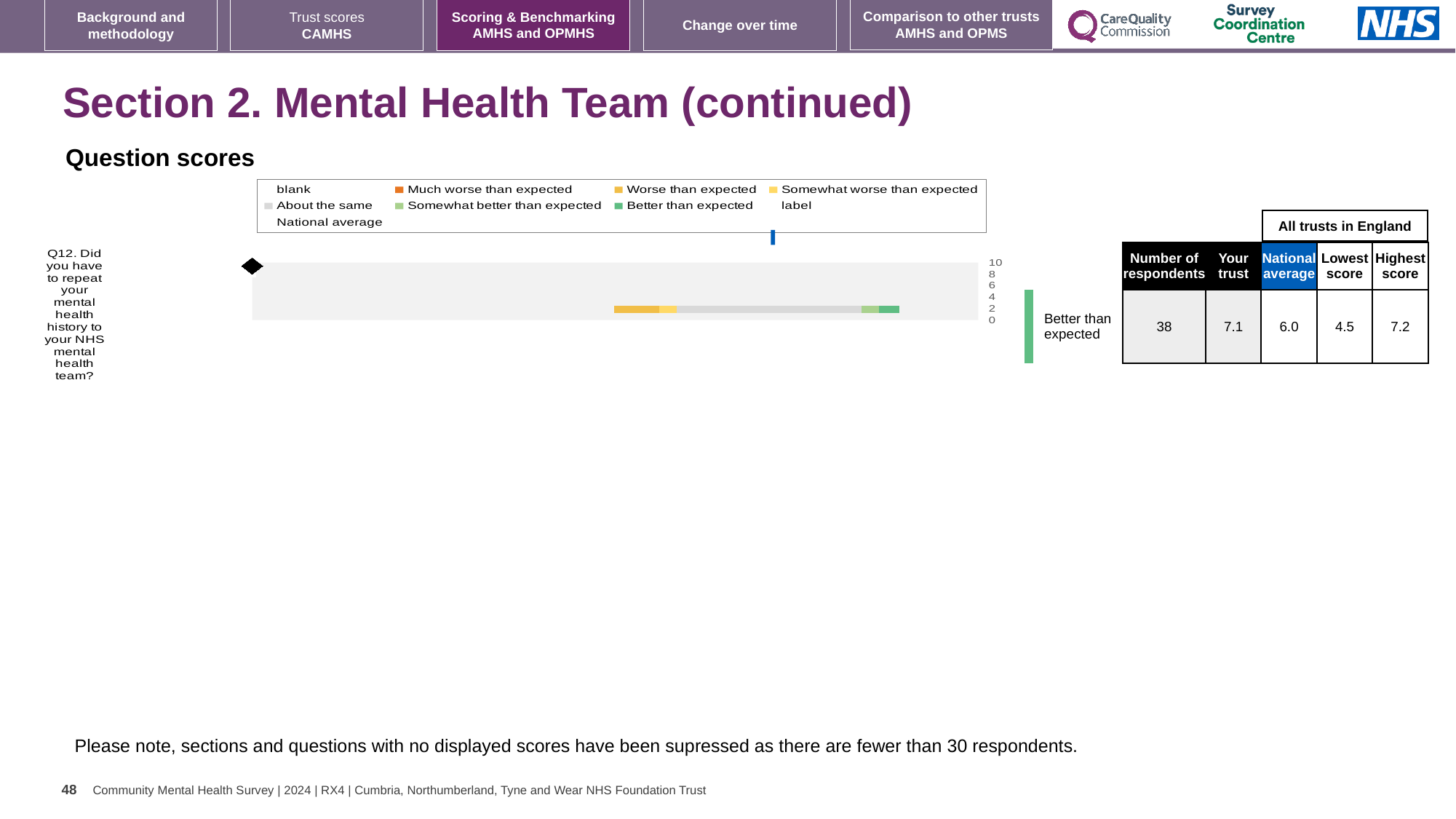
Which question is plotted in the Question scores chart? Q12. Did you have to repeat your mental health history to your NHS mental health team? What is the difference between the trust's Q12 score and the national average? 1.1 What benchmark category is shown for the trust's Q12 score? Better than expected Is the trust's Q12 score higher or lower than the national average? Higher What is the 'Your trust' score for Q12? 7.1 What is the lowest score among all trusts in England for Q12? 4.5 How many respondents answered Q12? 38 What is the difference between the highest and lowest Q12 scores among all trusts in England? 2.7 How many questions are plotted in the Question scores chart? 1 What is the national average score for Q12? 6.0 What kind of chart is used to show the Q12 question score? Bar chart What is the highest score among all trusts in England for Q12? 7.2